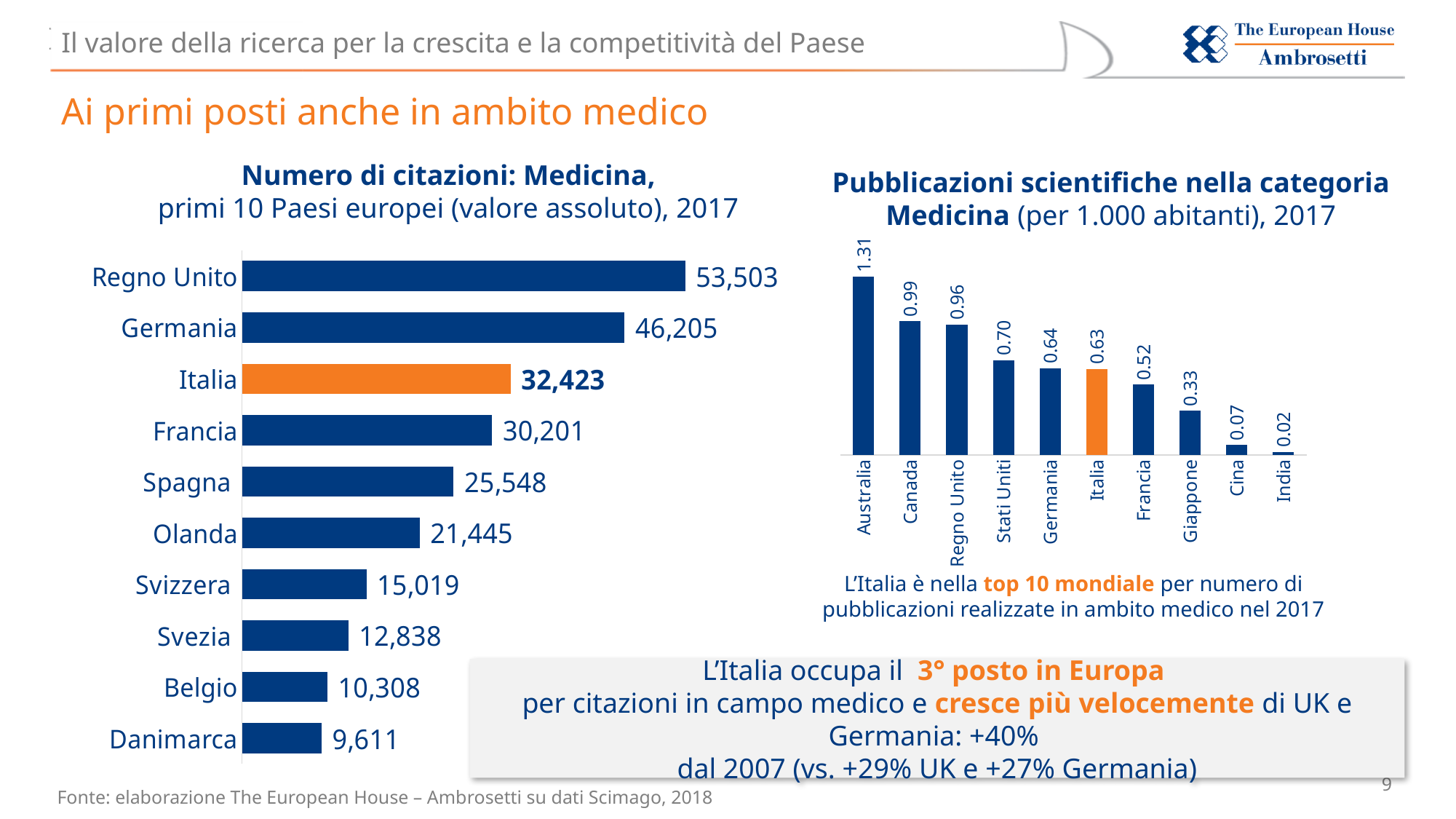
In the right chart (Pubblicazioni scientifiche nella categoria Medicina), which is larger, Canada or Regno Unito? Canada In the right chart (Pubblicazioni scientifiche nella categoria Medicina), what is the value for Australia? 1.31 In the left chart (Numero di citazioni: Medicina), what is the difference between Regno Unito and Germania? 7,298 In the right chart (Pubblicazioni scientifiche nella categoria Medicina), what is the difference between Stati Uniti and Italia? 0.07 In the left chart (Numero di citazioni: Medicina), how many countries are shown? 10 In the right chart (Pubblicazioni scientifiche nella categoria Medicina), which country has the lowest value? India In the left chart (Numero di citazioni: Medicina), what is the value for Italia? 32,423 In the left chart (Numero di citazioni: Medicina), which bar is highlighted in orange? Italia In the left chart (Numero di citazioni: Medicina), which country has the lowest number of citations? Danimarca In the left chart (Numero di citazioni: Medicina), which country has the highest number of citations? Regno Unito What type of chart is the right chart (Pubblicazioni scientifiche nella categoria Medicina)? Bar chart In the left chart (Numero di citazioni: Medicina), what is the value for Svizzera? 15,019